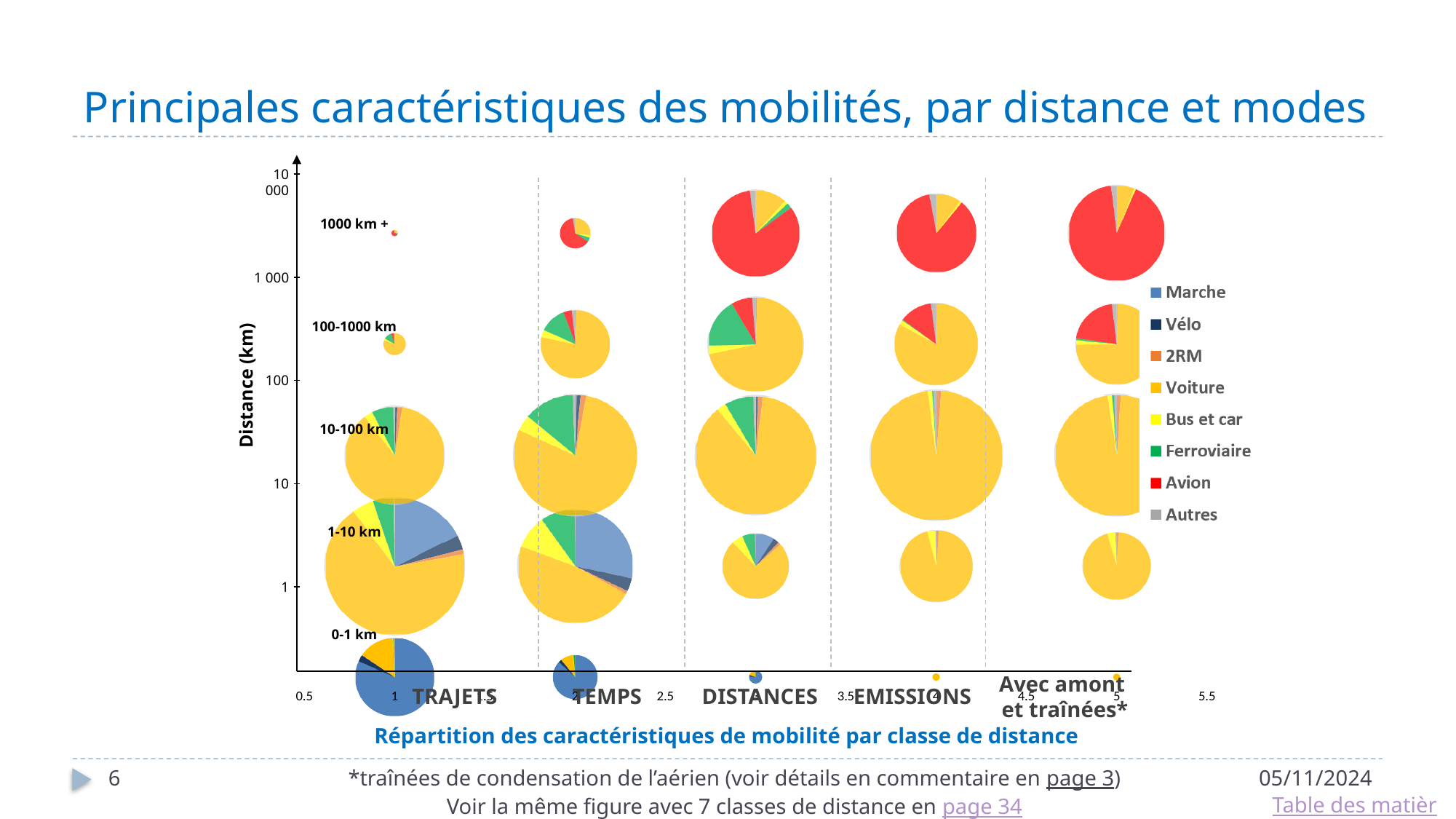
In the TRAJETS column, which bubble is larger: 1-10 km or 1000 km +? 1-10 km What is the label of the vertical axis? Distance (km) Which mode is listed first in the legend? Marche Which mode is shown in red in the legend? Avion How many modes does the legend list? 8 Which mode takes the largest share of the 0-1 km pie in the TRAJETS column? Marche Which mode takes the largest share of the 10-100 km pie in the EMISSIONS column? Voiture How many columns (TRAJETS, TEMPS, etc.) are shown along the horizontal axis? 5 What kind of chart is this? Pie charts (bubble chart of pies) Which mode takes the largest share of the 1000 km + pie in the DISTANCES column? Avion How many distance classes are labelled along the vertical axis? 5 In the DISTANCES column, which bubble is larger: 10-100 km or 0-1 km? 10-100 km